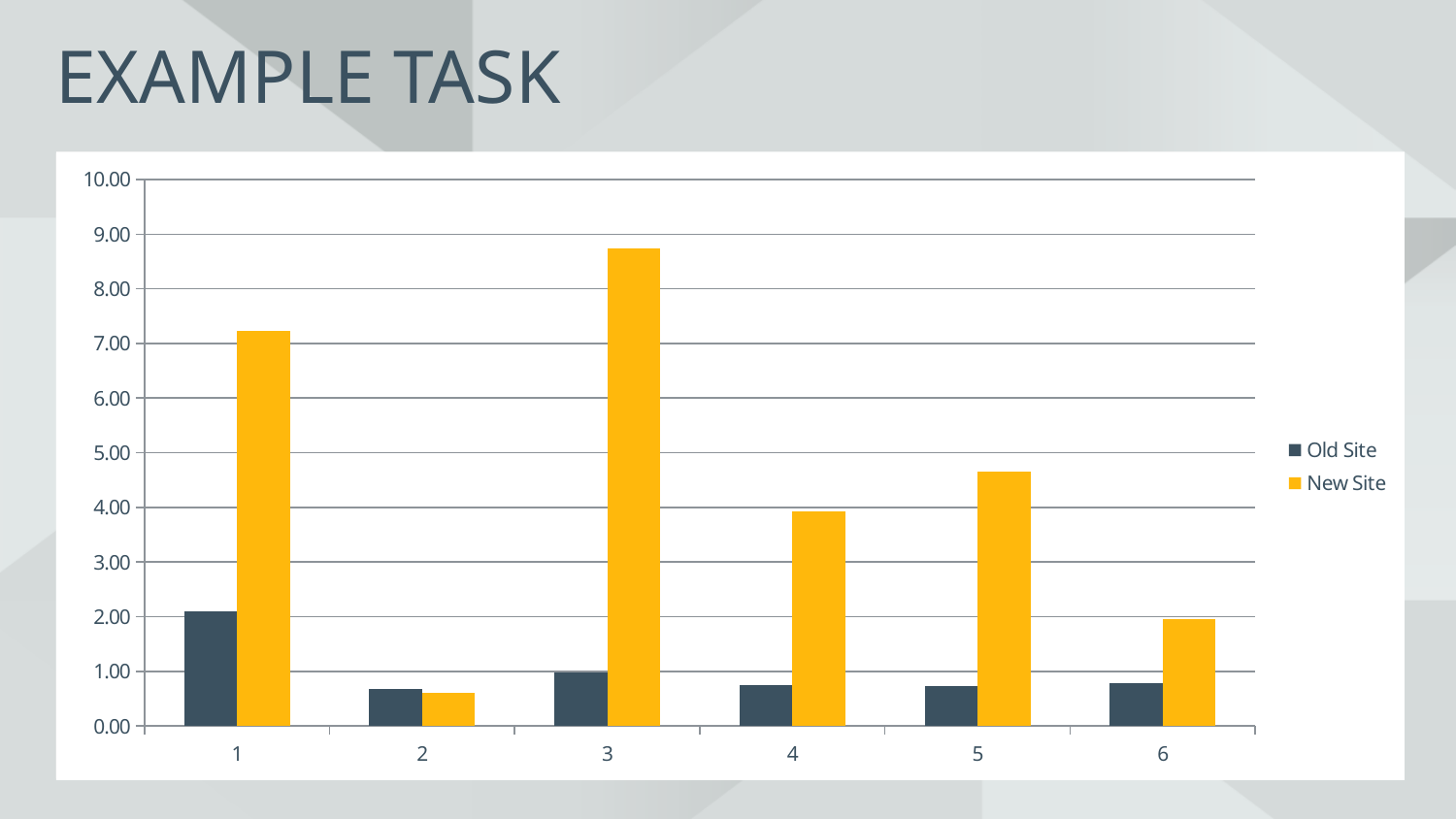
What are the two series named in the legend? Old Site and New Site Is the New Site value for category 3 greater or less than 8.00? greater How many series does the legend list? 2 What kind of chart is shown on the slide? bar chart For category 5, which series has the larger value, Old Site or New Site? New Site Is the Old Site value for category 2 greater or less than 1.00? less Is the New Site value for category 1 greater or less than 6.00? greater How many categories are shown on the x axis? 6 Which category has the highest New Site value? 3 Which category has the highest Old Site value? 1 Which category has the lowest New Site value? 2